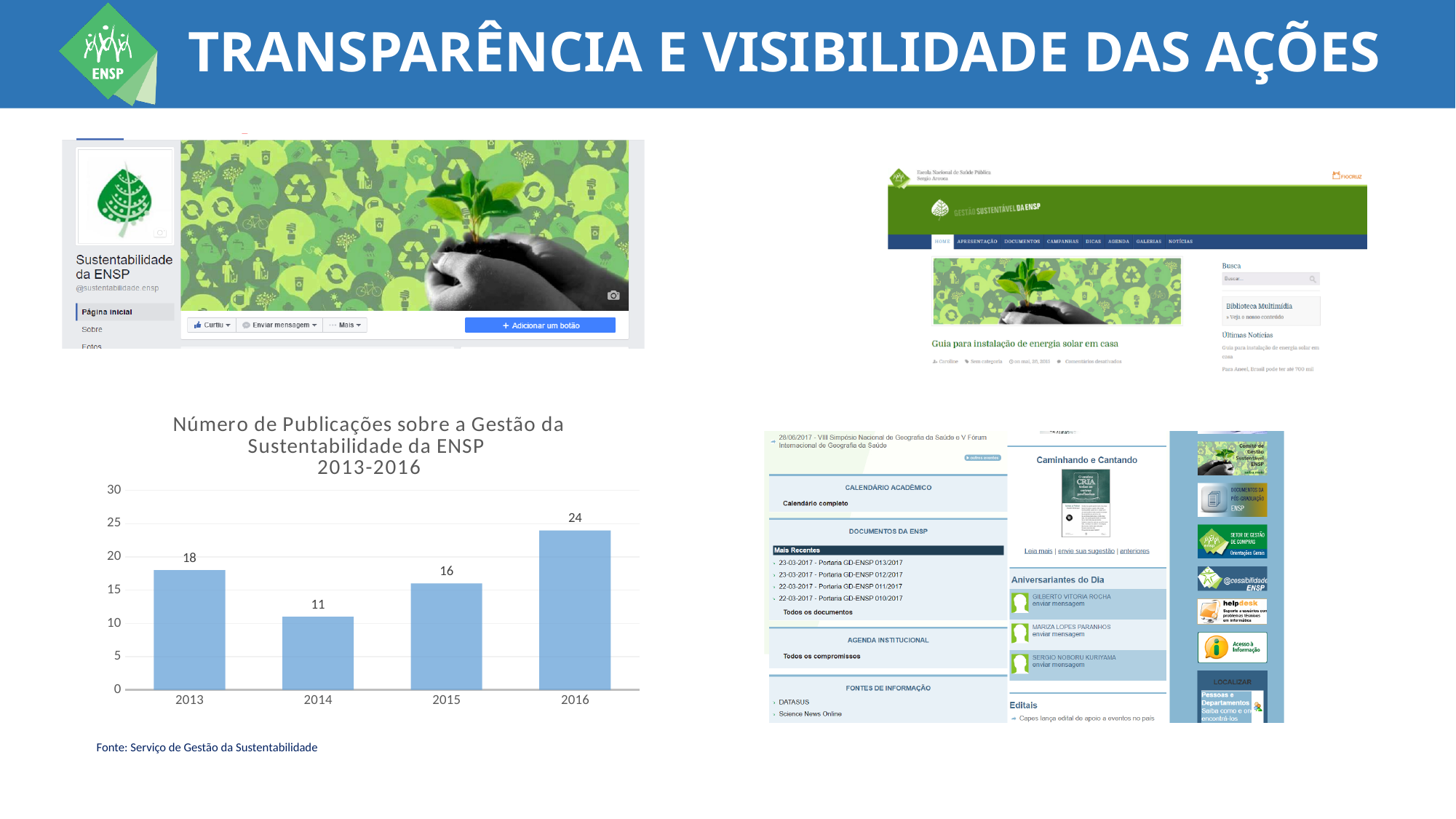
Which year has the highest number of publications? 2016 What is the difference between the number of publications in 2016 and 2014? 13 What is the title of the chart? Número de Publicações sobre a Gestão da Sustentabilidade da ENSP 2013-2016 What kind of chart is shown on the slide? bar chart Which year has the lowest number of publications? 2014 What is the number of publications in 2015? 16 Which year has more publications, 2013 or 2015? 2013 Is the value for 2016 greater or less than 20? greater What is the number of publications in 2014? 11 What is the number of publications in 2013? 18 How many years are shown on the x axis of the chart? 4 What is the number of publications in 2016? 24